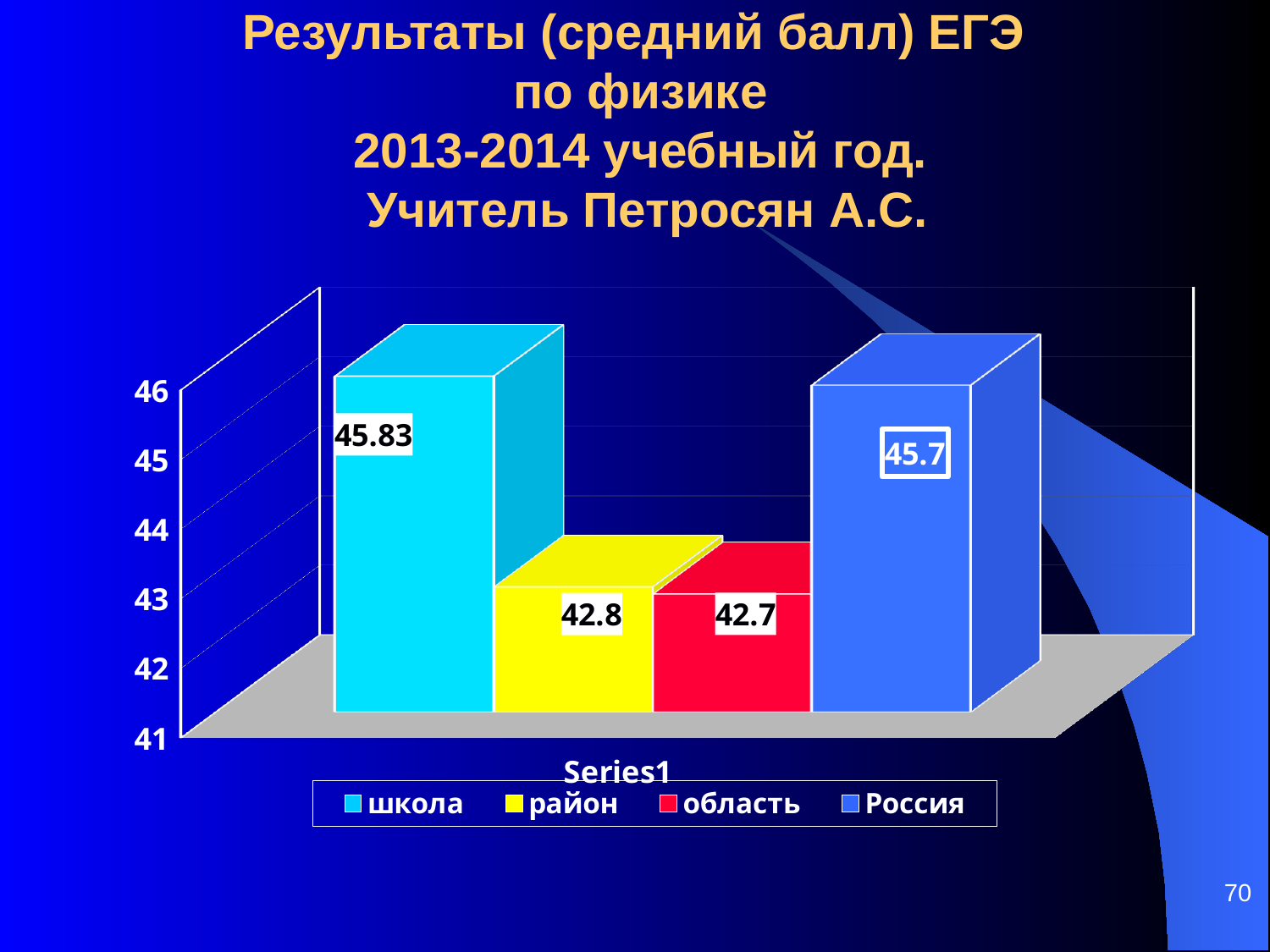
What is the value for район? 42.8 What is the value for область? 42.7 What is the difference between the values for школа and район? 3.03 What is the value for Россия? 45.7 What colour is the bar for район? yellow Which category has the lowest value? область What kind of chart is shown on the slide? bar chart Which is larger, the value for школа or the value for Россия? школа What is the value for школа? 45.83 What is the difference between the values for Россия and область? 3 How many bars are shown in the chart? 4 Which category has the highest value? школа